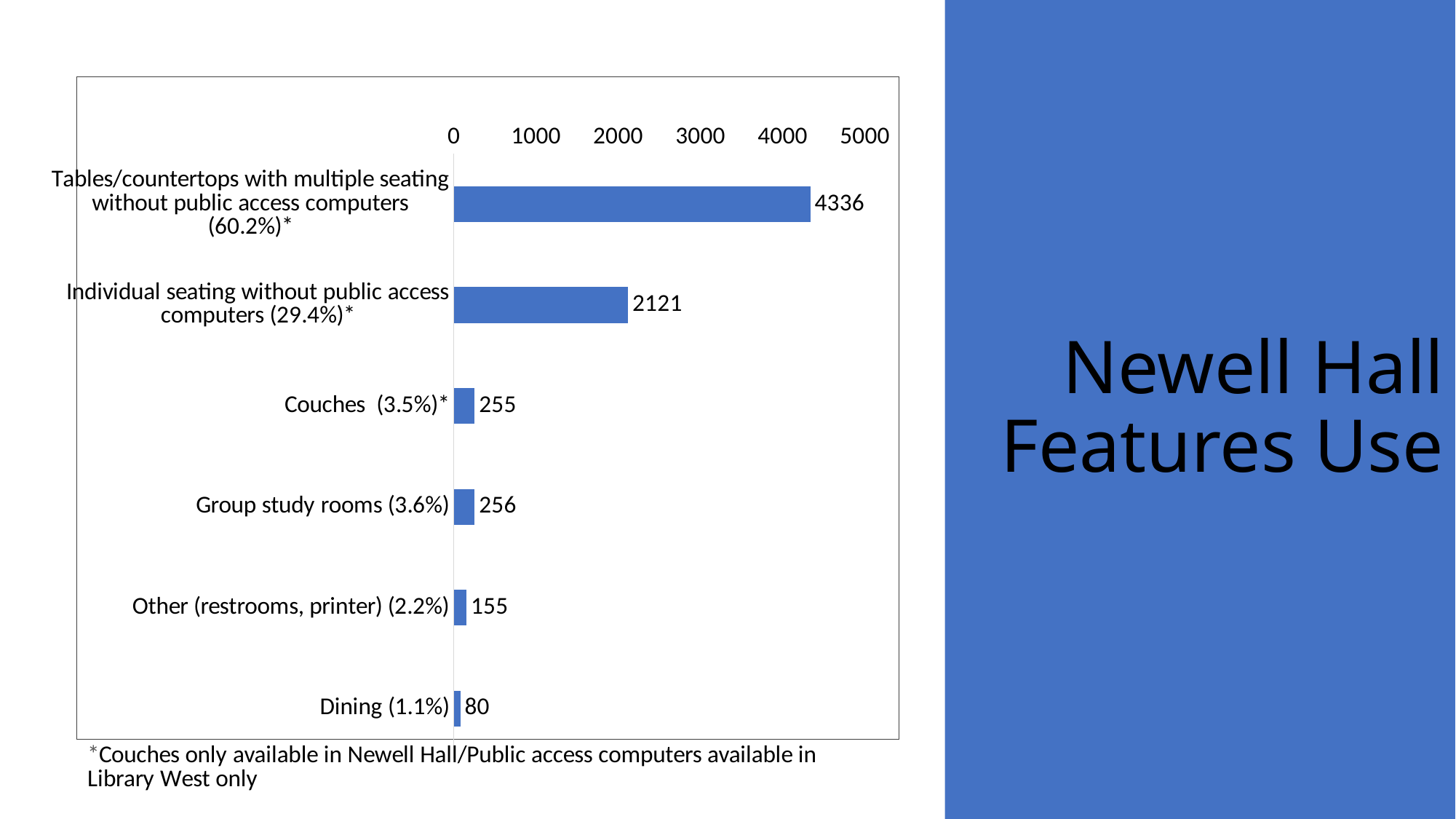
What is the value for Dining (1.1%)? 80 Which category has the highest value? Tables/countertops with multiple seating without public access computers (60.2%)* How many categories are shown in the chart? 6 What is the value for Other (restrooms, printer) (2.2%)? 155 Is the value for Tables/countertops with multiple seating without public access computers greater or less than 4000? greater Which category has the lowest value? Dining (1.1%) What is the value for Couches (3.5%)*? 255 Which is larger, the value for Individual seating without public access computers or the value for Couches? Individual seating without public access computers What is the difference between the values for Other (restrooms, printer) and Dining? 75 What kind of chart is shown on the slide? bar chart What is the value for Individual seating without public access computers (29.4%)*? 2121 What is the difference between the values for Tables/countertops with multiple seating without public access computers and Individual seating without public access computers? 2215